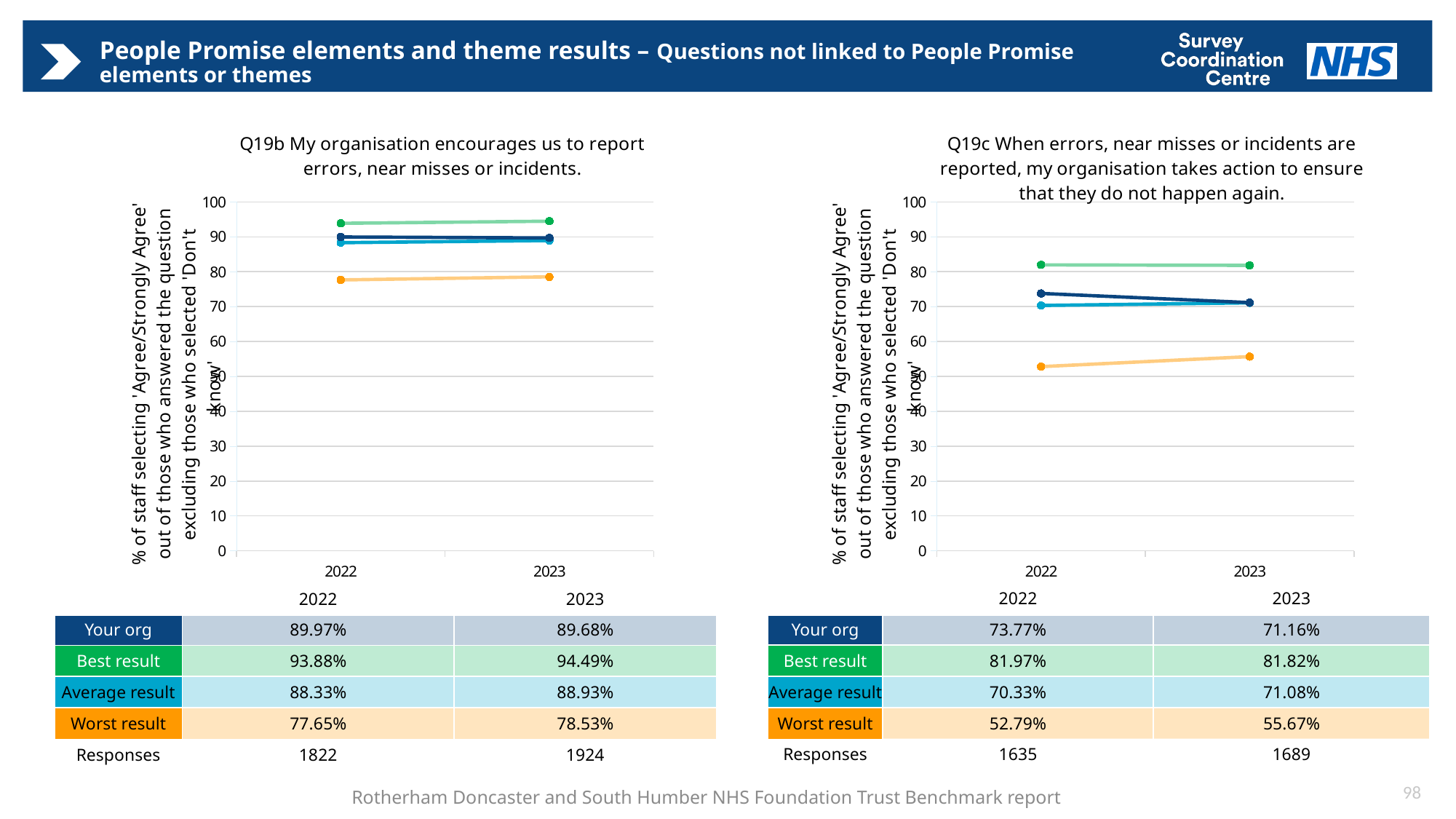
In the Q19b chart, what is the Best result value for 2022? 93.88% In the Q19c chart, is the Your org value higher in 2022 or 2023? 2022 In the Q19b chart, what is the difference between the Best result and Worst result values in 2022? 16.23% In the Q19b chart, what is the value for Your org in 2023? 89.68% In the Q19c chart, what is the difference between the Your org values for 2022 and 2023? 2.61% How many lines are plotted in the Q19c chart? 4 In the Q19c chart, which series has the highest value in 2022? Best result In the Q19c chart, what is the Average result value for 2022? 70.33% In the Q19b chart, which series has the lowest value in 2023? Worst result In the Q19c chart, does the Worst result line rise or fall from 2022 to 2023? rise What type of chart is used for Q19b? line chart In the Q19c chart, what is the Worst result value for 2023? 55.67%